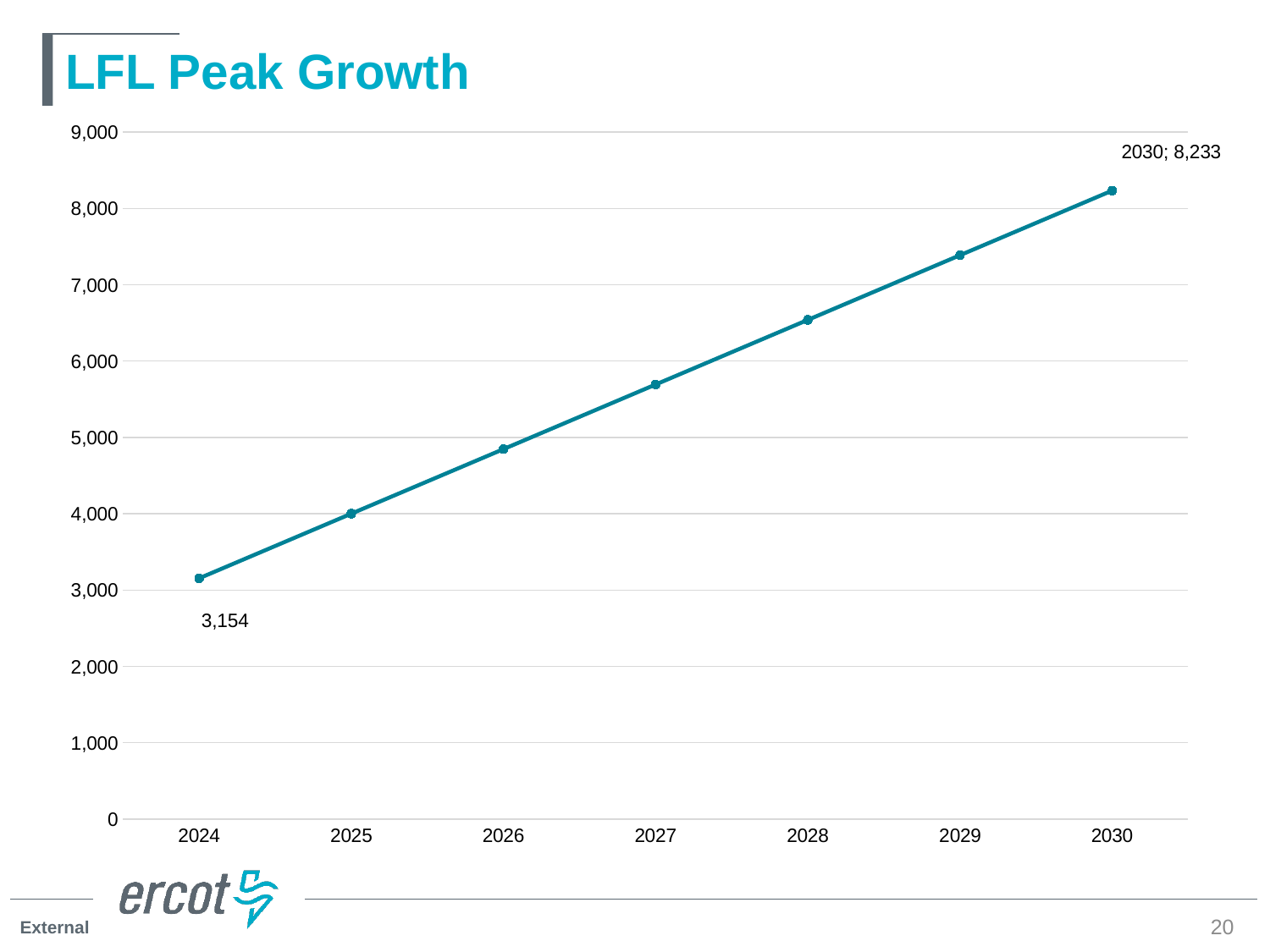
Do the values rise or fall from 2024 to 2030? rise Which is larger, the value for 2027 or the value for 2025? 2027 Which year has the highest value? 2030 Which year has the lowest value? 2024 How many years are plotted on the chart? 7 What is the value for 2024? 3,154 What kind of chart is shown? line chart What is the value for 2030? 8,233 What is the difference between the 2030 value and the 2024 value? 5,079 Is the value for 2026 greater or less than 5,000? less Is the value for 2028 greater or less than 6,000? greater Is the value for 2029 greater or less than 7,000? greater